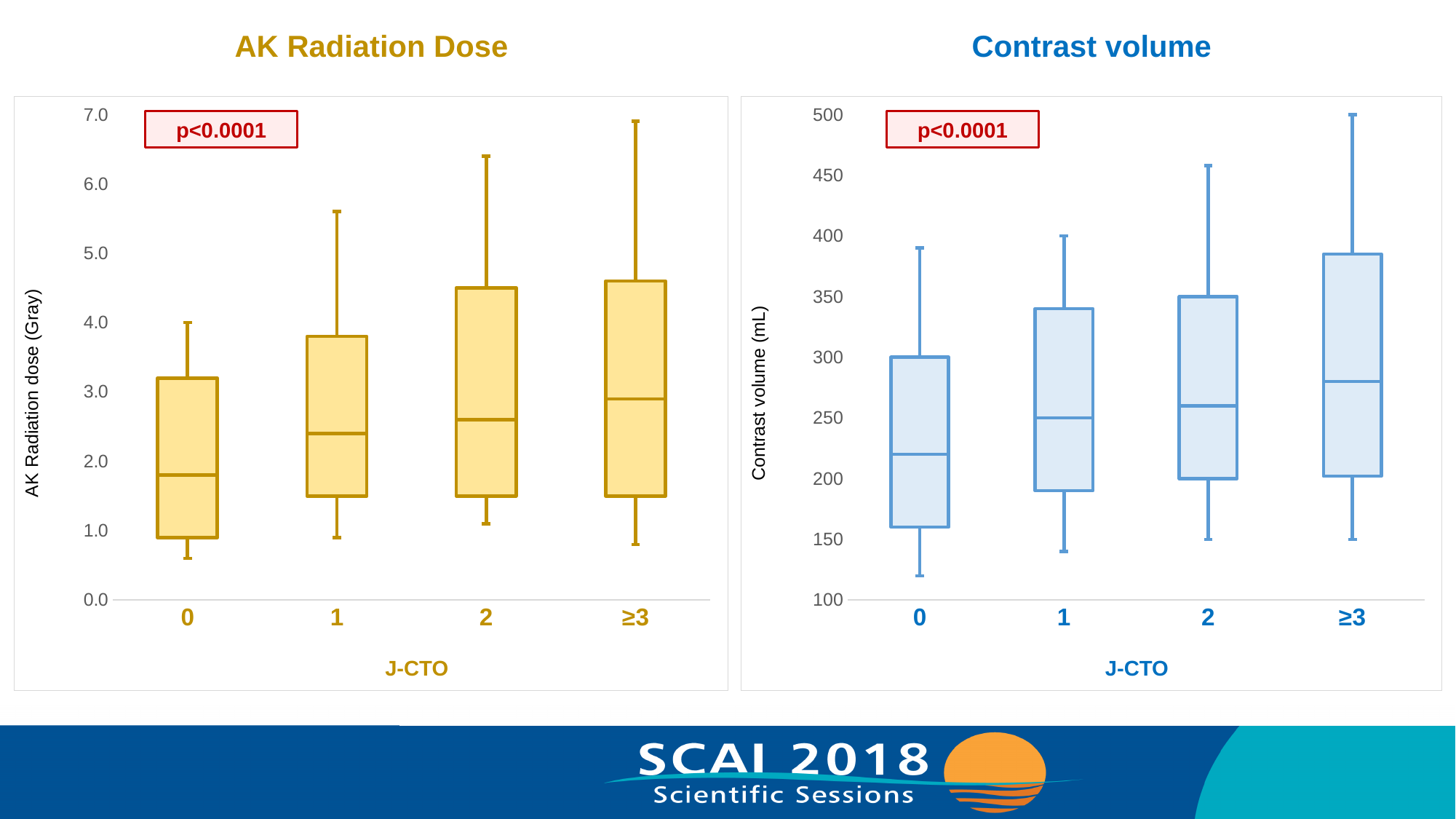
In the Contrast volume chart, is the median for J-CTO 0 greater or less than 250? less In the Contrast volume chart, do the median values rise or fall as J-CTO increases from 0 to ≥3? Rise What kind of chart is the AK Radiation Dose chart? Box plot In the AK Radiation Dose chart, is the median for J-CTO 0 greater or less than 2.0? less In the AK Radiation Dose chart, is the top of the upper whisker for J-CTO ≥3 greater or less than 6.0? greater In the AK Radiation Dose chart, which has the larger median: J-CTO 0 or J-CTO ≥3? ≥3 How many J-CTO categories are shown on the x axis of the Contrast volume chart? 4 In the AK Radiation Dose chart, do the median values rise or fall as J-CTO increases from 0 to ≥3? Rise What p-value is shown in the box on the Contrast volume chart? p<0.0001 In the Contrast volume chart, which J-CTO category has the highest median? ≥3 In the AK Radiation Dose chart, which J-CTO category has the lowest median? 0